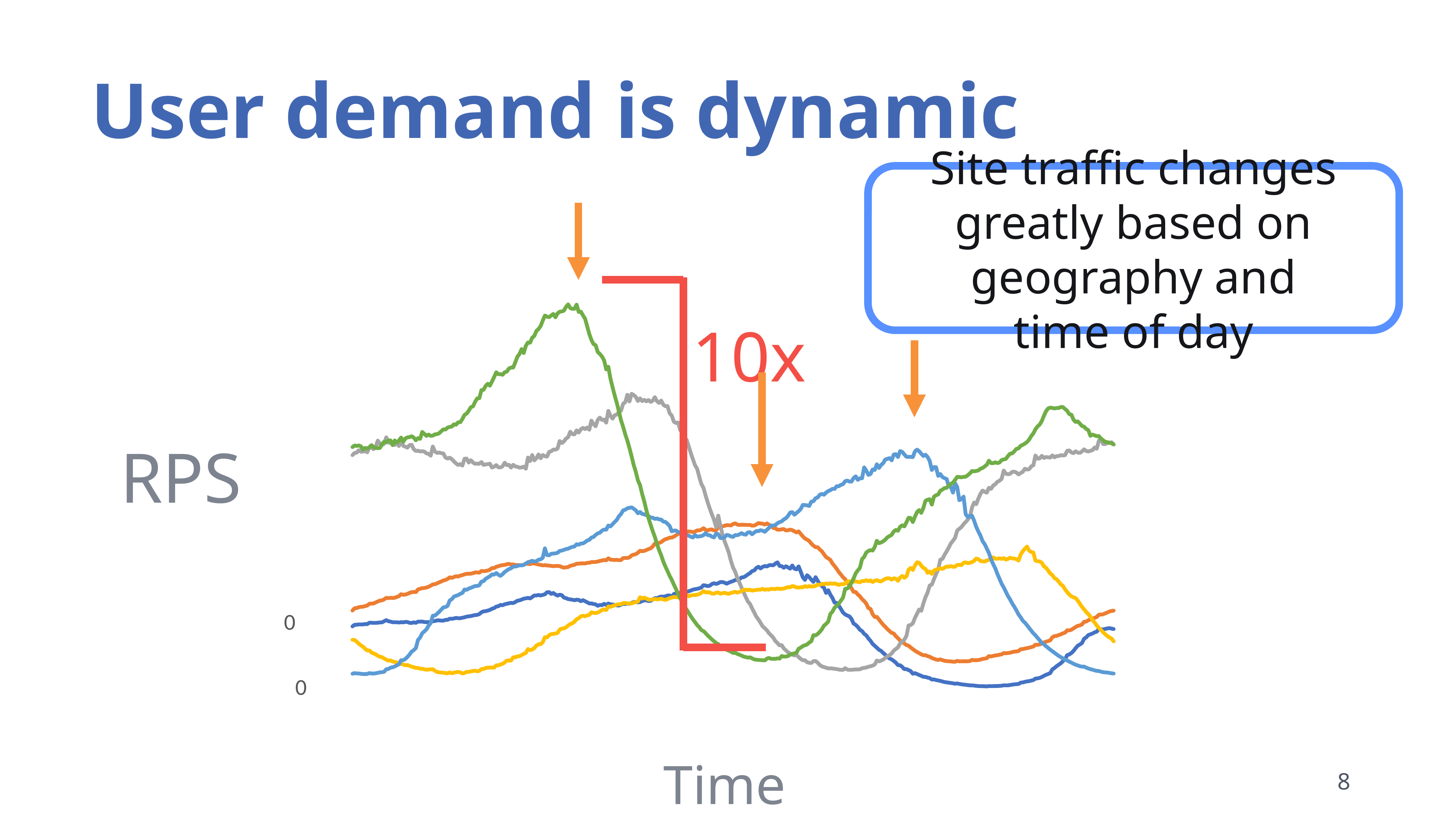
What kind of chart is shown on the slide? line chart How many lines are plotted on the chart? 6 Which coloured line reaches the highest peak on the chart? green At the far left of the chart, is the green line above or below the orange line? above What are the labels on the y axis and x axis of the chart? RPS and Time Does the green line rise or fall from the left edge of the chart up to its first peak? rise What factor is written in red next to the bracket on the chart? 10x